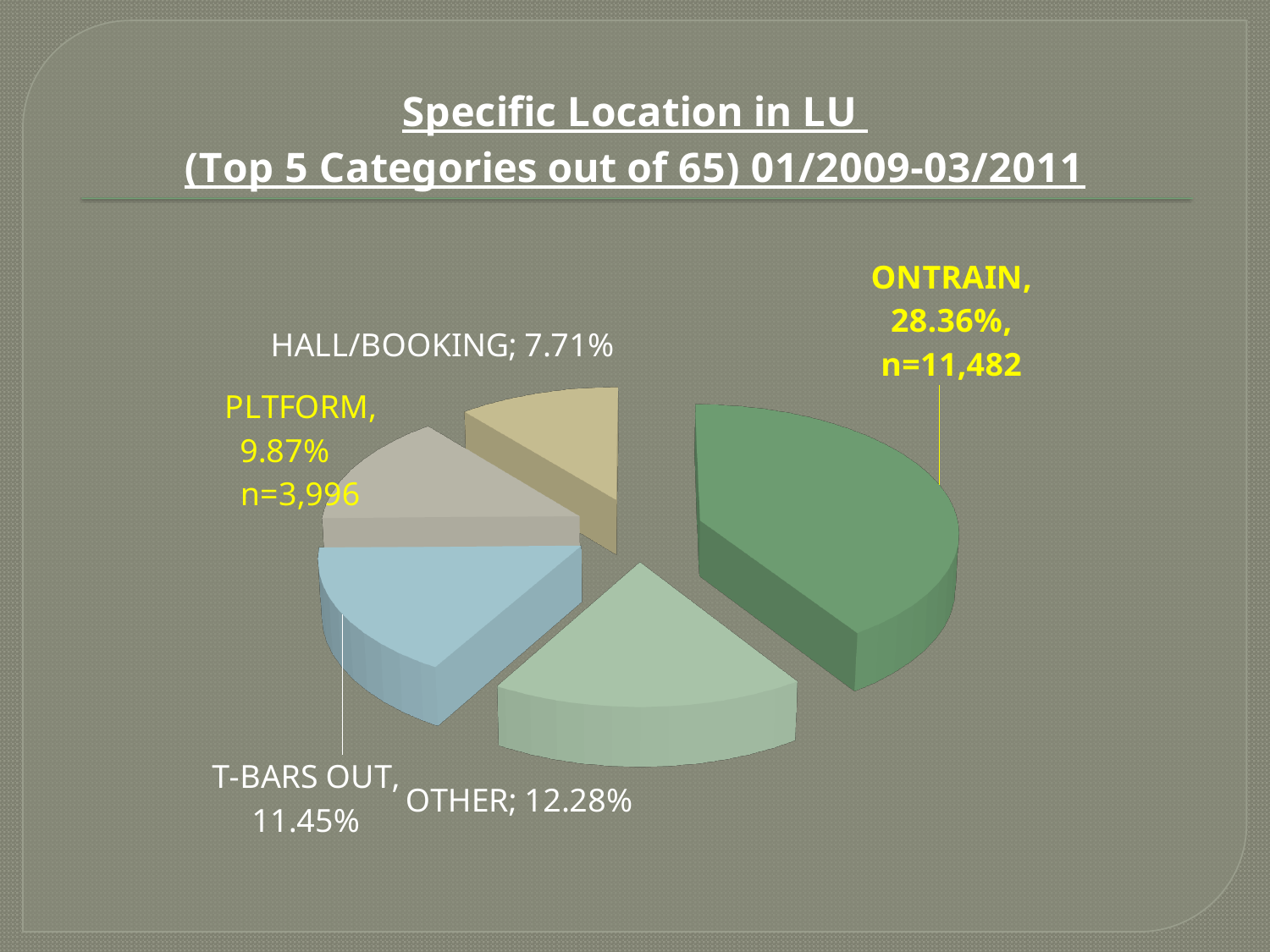
How many slices does the pie chart have? 5 What is the n value shown for PLTFORM? n=3,996 What is the difference in percentage points between ONTRAIN and OTHER? 16.08 What percentage is shown for OTHER? 12.28% What is the n value shown for ONTRAIN? n=11,482 Which has a larger share, T-BARS OUT or PLTFORM? T-BARS OUT What percentage is shown for T-BARS OUT? 11.45% What percentage is shown for ONTRAIN? 28.36% Which category has the smallest share of the pie? HALL/BOOKING Which category has the largest share of the pie? ONTRAIN What percentage is shown for PLTFORM? 9.87% What percentage is shown for HALL/BOOKING? 7.71%